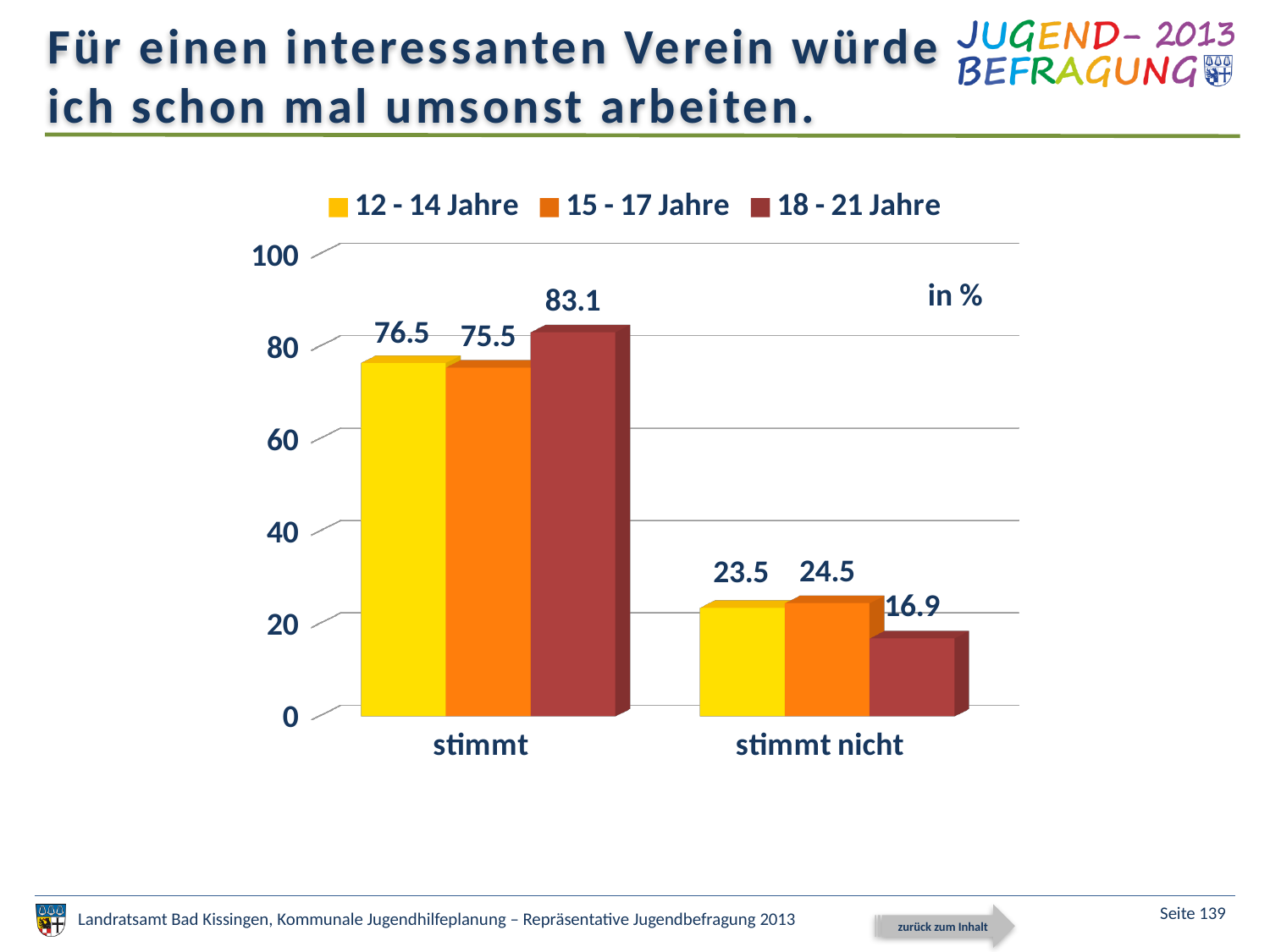
Which age group has the lowest value in the "stimmt nicht" category? 18 - 21 Jahre What is the difference between the 18 - 21 Jahre and 12 - 14 Jahre values in the "stimmt" category? 6.6 What is the value for the 15 - 17 Jahre series in the "stimmt" category? 75.5 What kind of chart is shown on the slide? bar chart What is the difference between the 15 - 17 Jahre and 18 - 21 Jahre values in the "stimmt nicht" category? 7.6 Which age group has the highest value in the "stimmt" category? 18 - 21 Jahre How many series does the legend list? 3 How many categories are shown on the x axis? 2 What is the value for the 12 - 14 Jahre series in the "stimmt" category? 76.5 What is the value for the 18 - 21 Jahre series in the "stimmt nicht" category? 16.9 Is the value for 18 - 21 Jahre in the "stimmt" category greater or less than 80? greater In the "stimmt nicht" category, which is larger: the 12 - 14 Jahre value or the 15 - 17 Jahre value? 15 - 17 Jahre